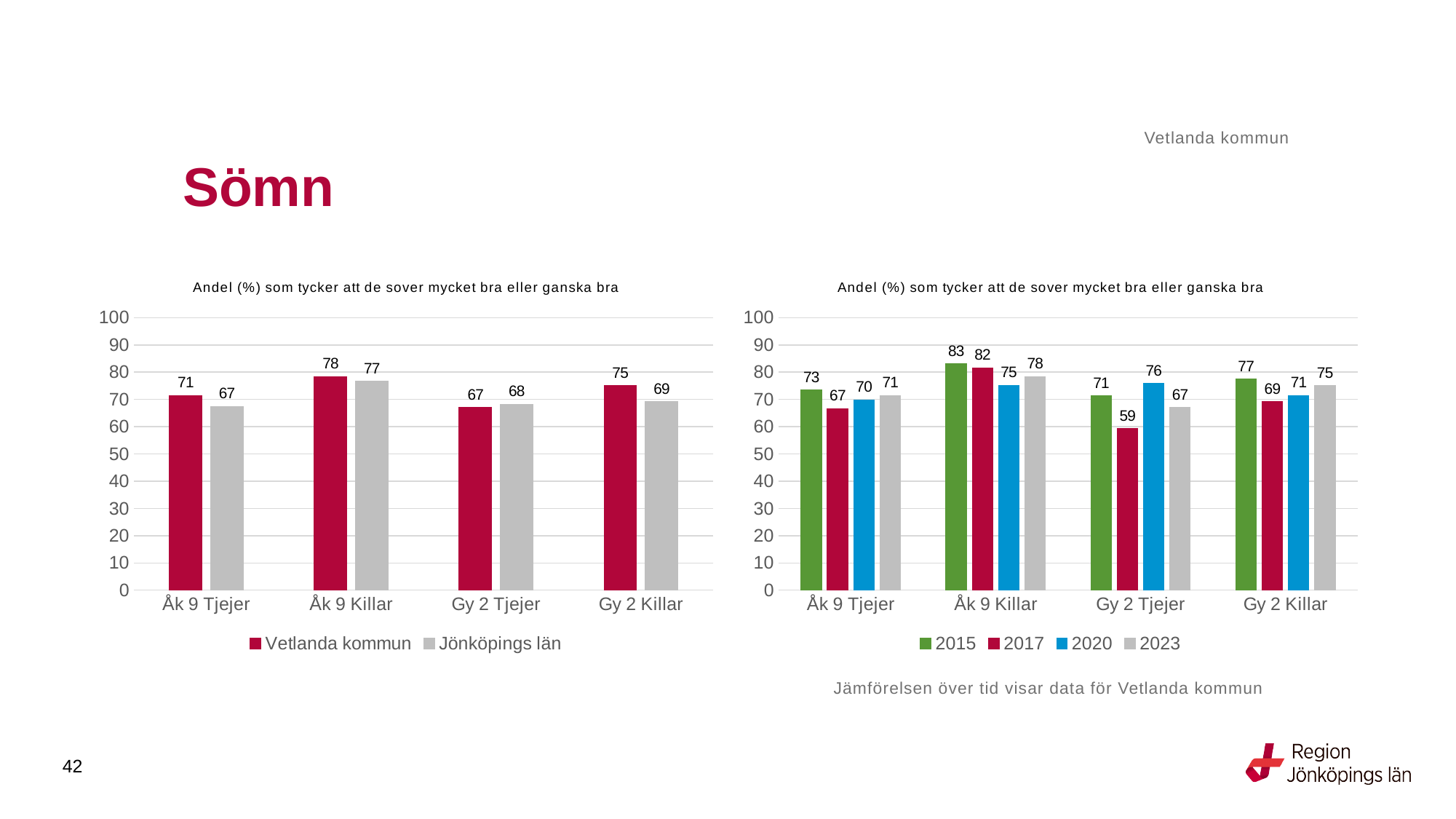
In the left chart, what is the value for Vetlanda kommun for Åk 9 Killar? 78 What kind of chart is the left chart? Bar chart In the right chart, which is larger for Gy 2 Killar: the 2015 value or the 2023 value? 2015 In the right chart, what is the value for 2023 for Åk 9 Killar? 78 In the right chart, what is the difference between the 2015 and 2023 values for Åk 9 Killar? 5 In the left chart, which category has the highest value for Vetlanda kommun? Åk 9 Killar In the right chart, what is the value for 2017 for Gy 2 Tjejer? 59 In the right chart, how many series does the legend list? 4 In the left chart, what is the difference between Vetlanda kommun and Jönköpings län for Åk 9 Tjejer? 4 In the left chart, how many series does the legend list? 2 In the left chart, what is the value for Jönköpings län for Gy 2 Tjejer? 68 In the right chart, which year has the lowest value for Gy 2 Tjejer? 2017